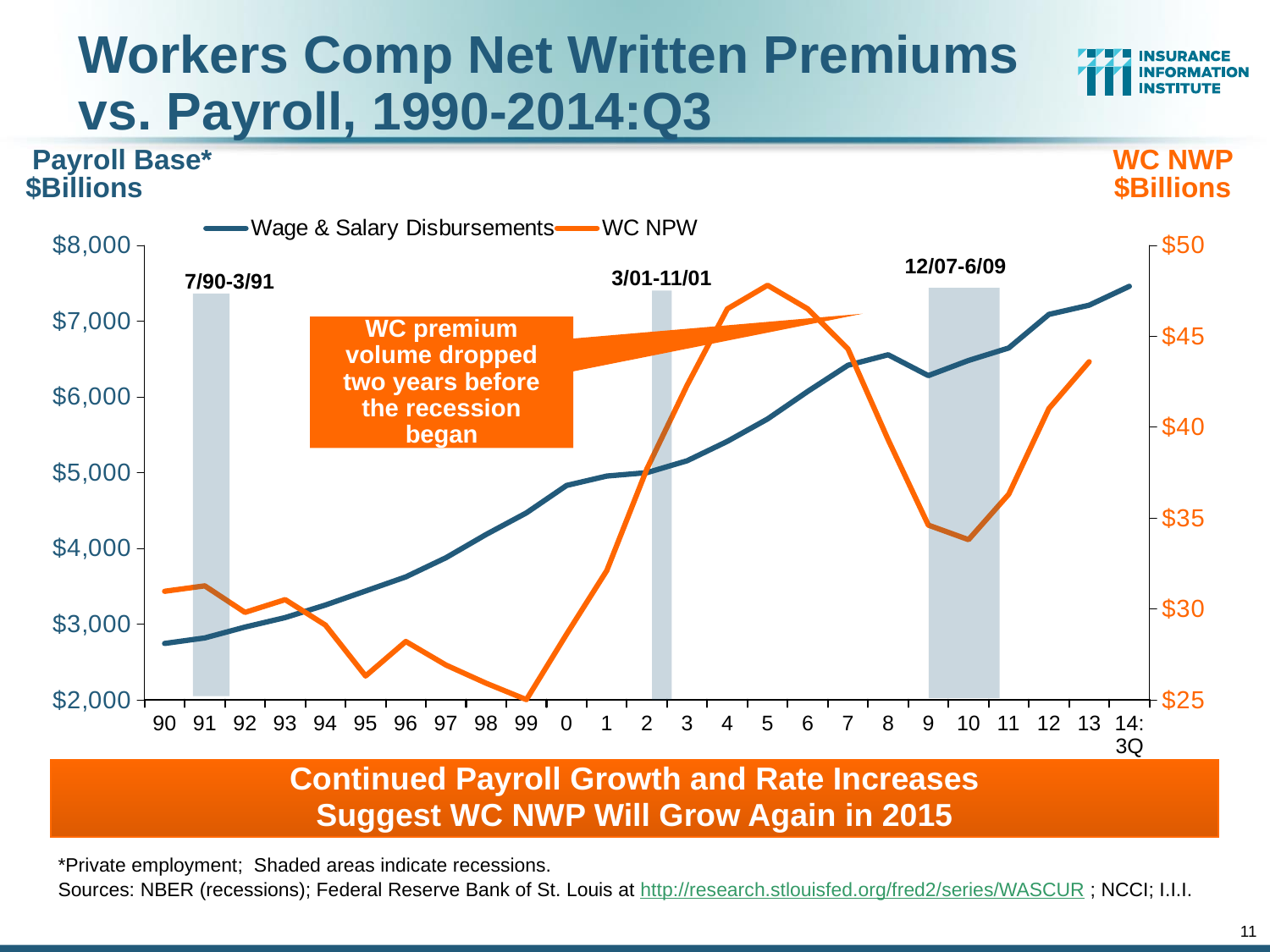
What kind of chart is shown on the slide? Line chart How many series does the legend list? 2 How many points are labeled along the x axis, from 90 to 14:3Q? 25 Does the Wage & Salary Disbursements line generally rise or fall from 90 to 14:3Q? rise Which is larger, the WC NPW value for 5 or for 10? 5 In which year does the WC NPW line reach its highest value? 5 (2005) At which x-axis point is the Wage & Salary Disbursements line highest? 14:3Q In which year does the WC NPW line reach its lowest value? 99 What are the two series named in the legend? Wage & Salary Disbursements and WC NPW Is the Wage & Salary Disbursements value for 90 greater or less than $3,000? less Is the WC NPW value for 5 greater or less than $45? greater Is the Wage & Salary Disbursements value for 13 greater or less than $7,000? greater